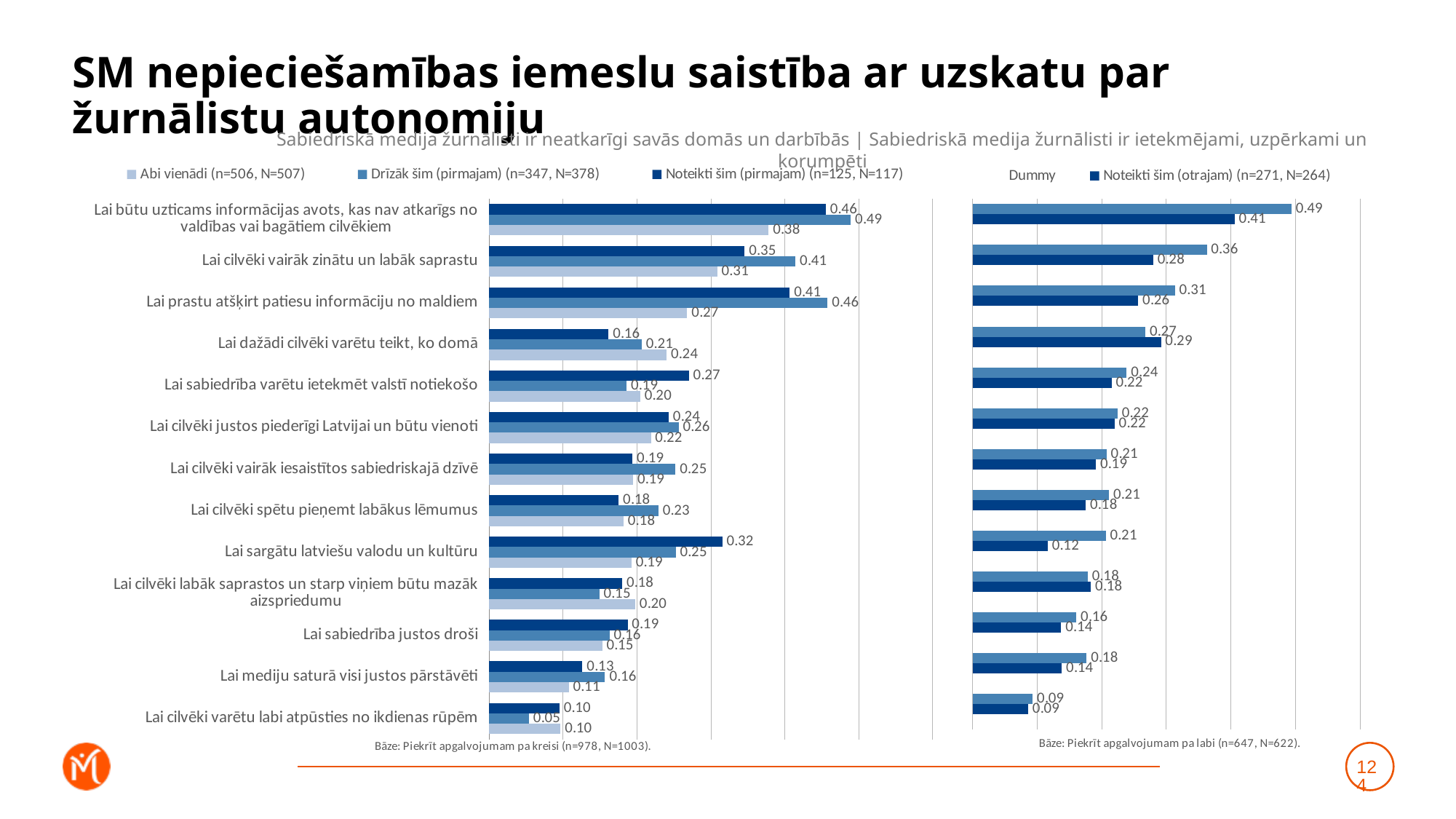
How many categories are listed on the left chart? 13 On the right chart, what is the difference between the two values shown for 'Lai sargātu latviešu valodu un kultūru'? 0.09 On the left chart, for 'Lai sabiedrība varētu ietekmēt valstī notiekošo', which is larger: 'Noteikti šim (pirmajam)' or 'Abi vienādi'? Noteikti šim (pirmajam) What is the base note printed under the right chart? Bāze: Piekrīt apgalvojumam pa labi (n=647, N=622). On the left chart, what is the value of 'Abi vienādi' for 'Lai būtu uzticams informācijas avots, kas nav atkarīgs no valdības vai bagātiem cilvēkiem'? 0.38 On the left chart, which category has the lowest 'Drīzāk šim (pirmajam)' value? Lai cilvēki varētu labi atpūsties no ikdienas rūpēm On the left chart, what is the value of 'Noteikti šim (pirmajam)' for 'Lai sargātu latviešu valodu un kultūru'? 0.32 What type of chart is the left chart? Bar chart On the right chart, what is the value of 'Noteikti šim (otrajam)' for 'Lai cilvēki vairāk zinātu un labāk saprastu'? 0.28 How many series does the legend of the left chart list? 3 On the left chart, what is the difference between 'Drīzāk šim (pirmajam)' and 'Abi vienādi' for 'Lai prastu atšķirt patiesu informāciju no maldiem'? 0.19 On the left chart, which category has the highest 'Drīzāk šim (pirmajam)' value? Lai būtu uzticams informācijas avots, kas nav atkarīgs no valdības vai bagātiem cilvēkiem